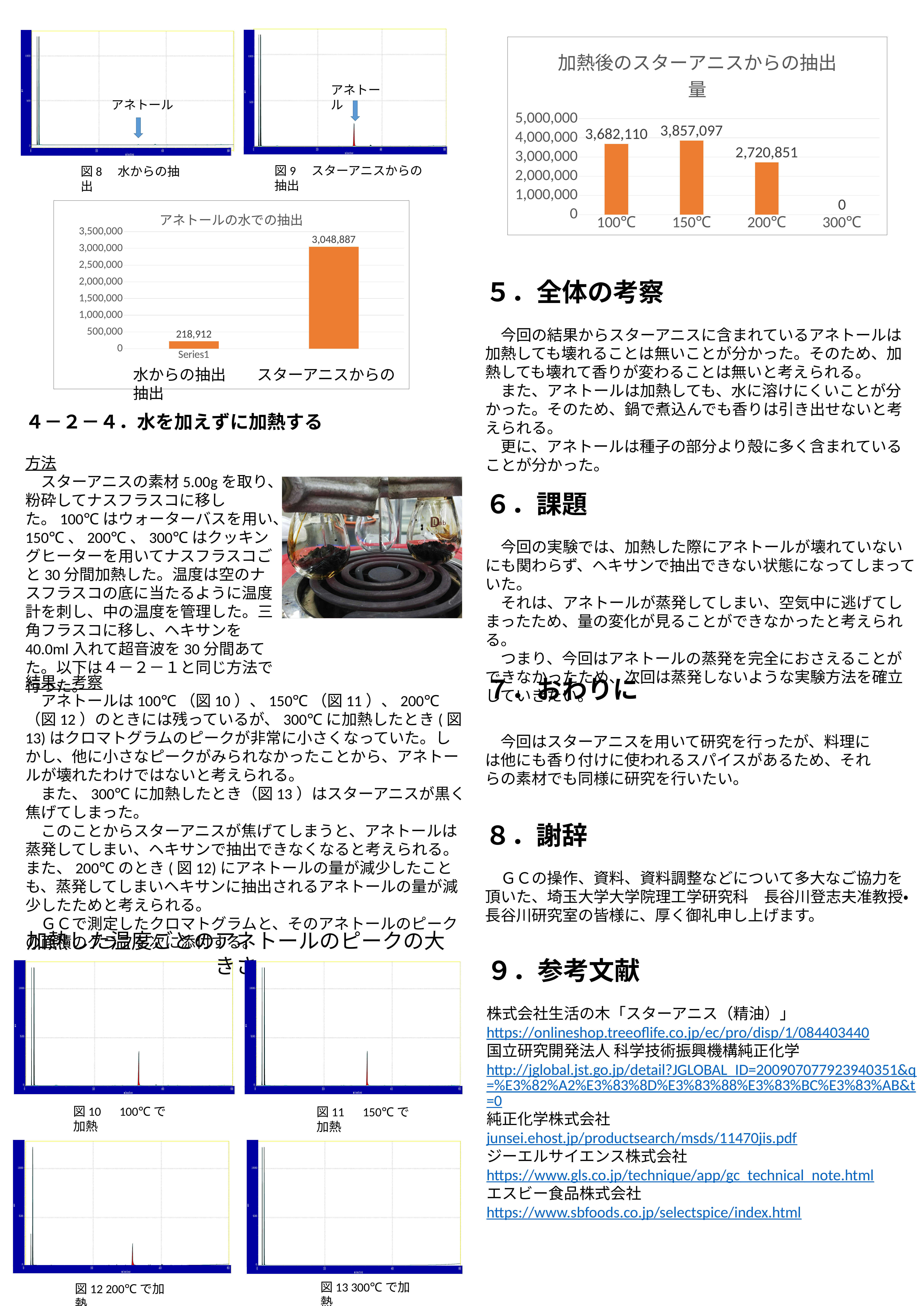
In the chart titled 加熱後のスターアニスからの抽出量, which temperature has the lowest value? 300℃ In the chart titled 加熱後のスターアニスからの抽出量, what is the value for 150℃? 3,857,097 In the chart titled アネトールの水での抽出, what is the value for 水からの抽出? 218,912 In the chart titled アネトールの水での抽出, which category has the larger value, 水からの抽出 or スターアニスからの抽出? スターアニスからの抽出 What type of chart is the chart titled アネトールの水での抽出? bar chart In the chart titled 加熱後のスターアニスからの抽出量, what is the difference between the values for 100℃ and 200℃? 961,259 In the chart titled 加熱後のスターアニスからの抽出量, which temperature has the highest value? 150℃ In the chart titled 加熱後のスターアニスからの抽出量, how many temperature categories are shown? 4 In the chart titled 加熱後のスターアニスからの抽出量, what is the value for 200℃? 2,720,851 In the chart titled 加熱後のスターアニスからの抽出量, is the value for 200℃ greater or less than 3,000,000? less In the chart titled アネトールの水での抽出, what is the difference between the two bars? 2,829,975 In the chart titled アネトールの水での抽出, what is the value for スターアニスからの抽出? 3,048,887